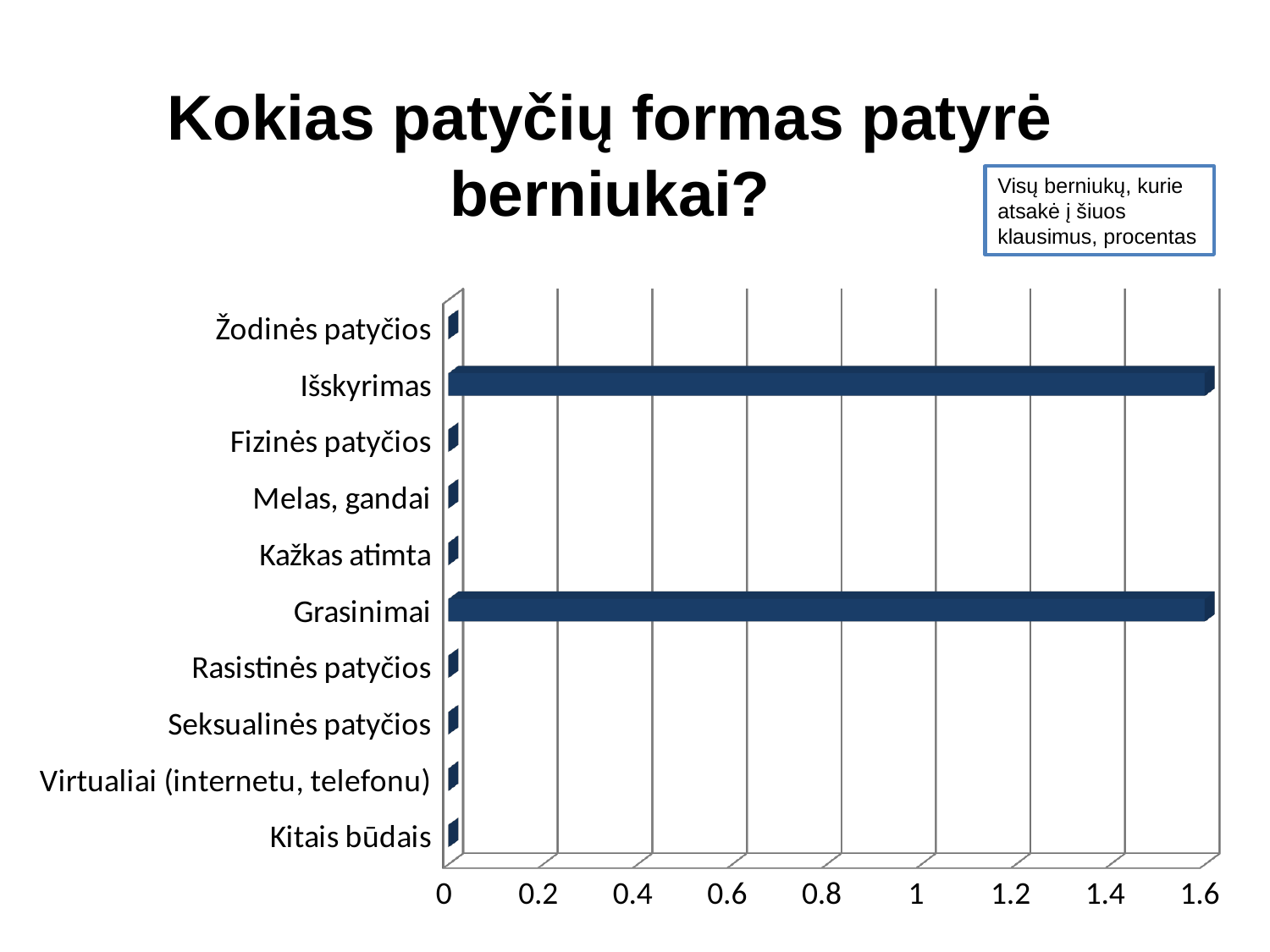
What is the highest value shown on the horizontal axis? 1.6 Which is larger, the value for Išskyrimas or the value for Fizinės patyčios? Išskyrimas What kind of chart is shown on the slide? bar chart Which is larger, the value for Kitais būdais or the value for Grasinimai? Grasinimai Is the value for Melas, gandai greater or less than 0.2? less Is the value for Išskyrimas greater or less than 1? greater Which category is listed first (at the top) of the chart? Žodinės patyčios What is the title of the slide above the chart? Kokias patyčių formas patyrė berniukai? Is the value for Grasinimai greater or less than 1.4? greater How many categories are shown on the chart? 10